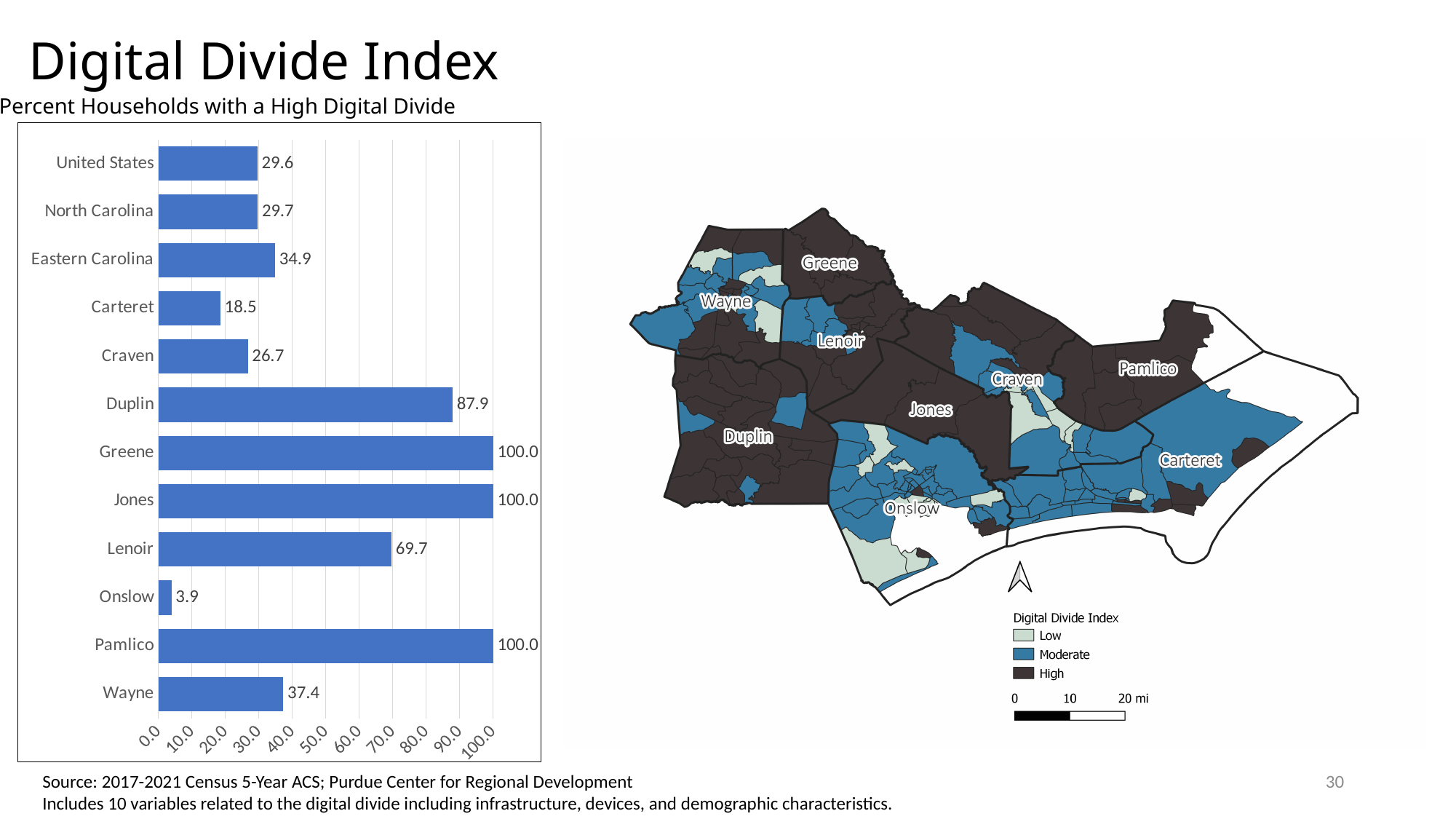
Which category has the lowest value in the bar chart? Onslow Which is larger in the bar chart, Wayne or Carteret? Wayne What is the difference between the values for Lenoir and Craven in the bar chart? 43.0 What kind of chart is shown on the left of the slide? Bar chart What is the value for Onslow in the bar chart? 3.9 What is the value for Duplin in the bar chart? 87.9 How many categories in the bar chart have a value of 100.0? 3 How many categories are shown in the bar chart? 12 What is the difference between the values for North Carolina and the United States in the bar chart? 0.1 What is the subtitle of the bar chart? Percent Households with a High Digital Divide How many categories does the map legend for the Digital Divide Index list? 3 What is the value for Eastern Carolina in the bar chart? 34.9